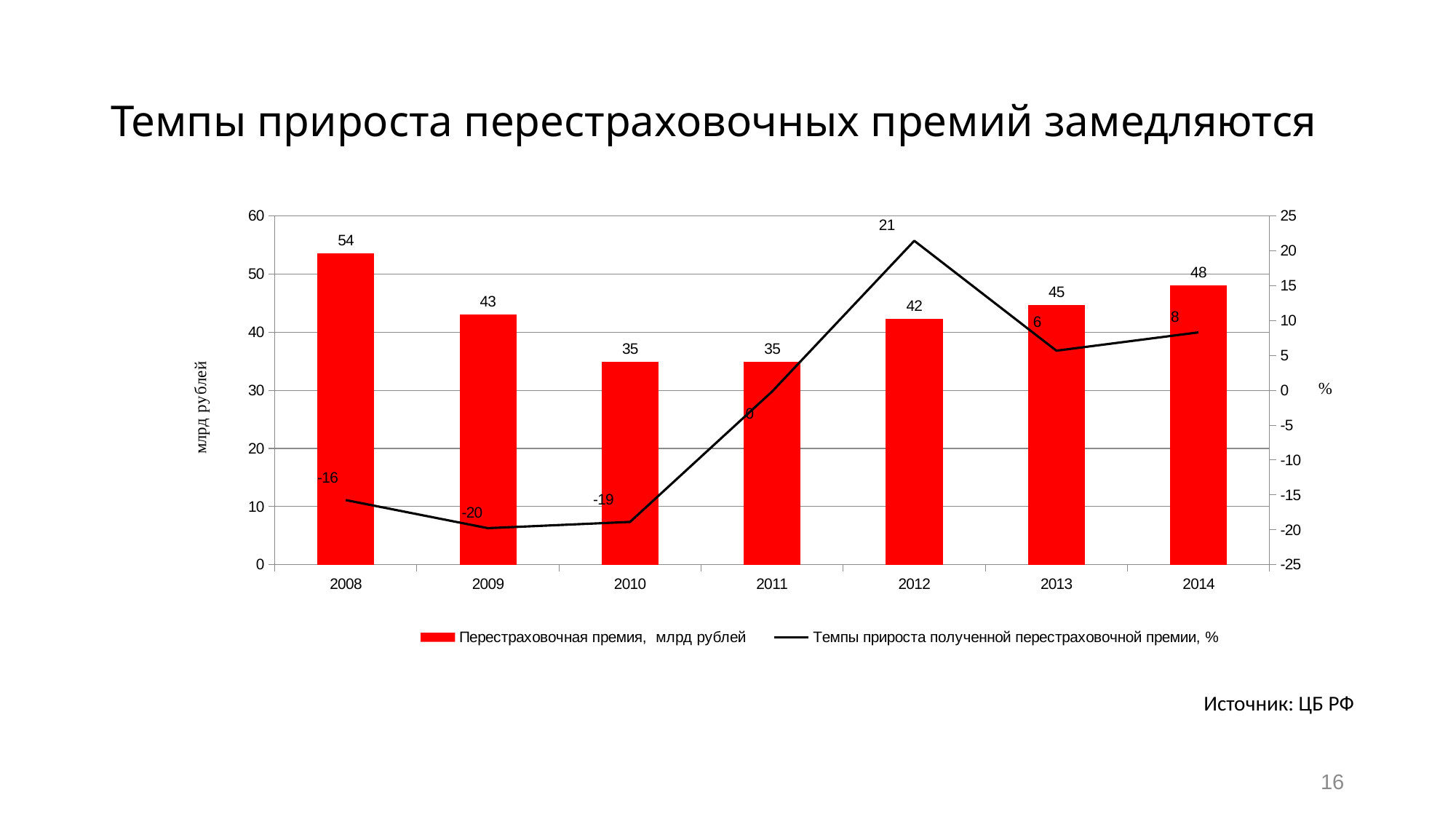
What is the difference between the reinsurance premium in 2008 and in 2014? 6 What kind of chart is shown on the slide? Combined bar and line chart What is the reinsurance premium (Перестраховочная премия, млрд рублей) for 2008? 54 Which year has the highest reinsurance premium (млрд рублей)? 2008 Which is larger, the reinsurance premium in 2013 or in 2012? 2013 What is the growth rate (Темпы прироста, %) for 2009? -20 What is the title of the slide? Темпы прироста перестраховочных премий замедляются What is the growth rate (Темпы прироста, %) for 2012? 21 Which year has the lowest growth rate (Темпы прироста, %)? 2009 How many years are shown on the x axis? 7 Does the reinsurance premium rise or fall from 2008 to 2010? Fall How many series does the legend list? 2